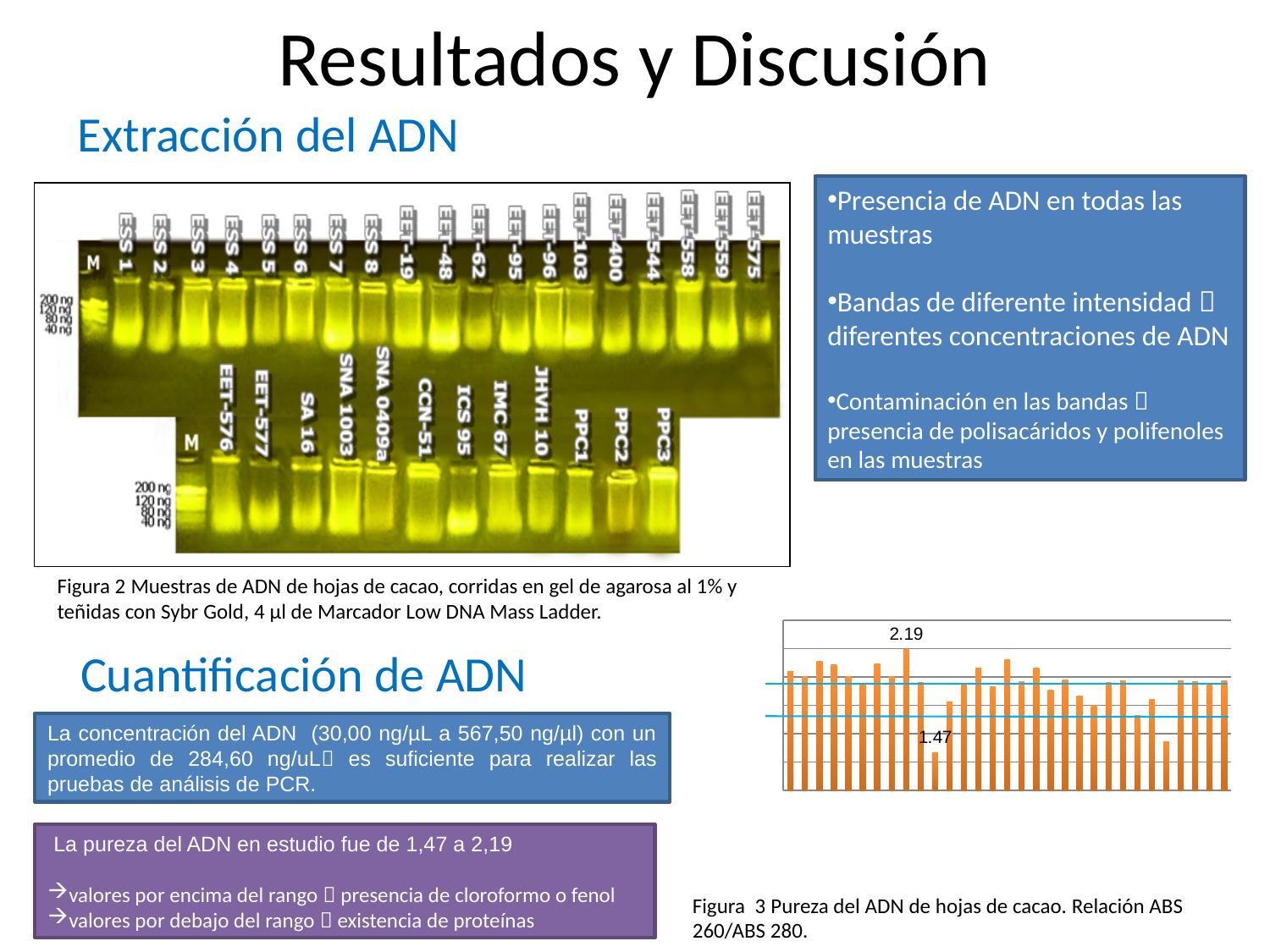
What colour are the bars in the Figura 3 bar chart? orange In the Figura 3 bar chart, what is the highest value labeled on the chart? 2.19 According to the caption, what does the bar chart in Figura 3 show? Pureza del ADN de hojas de cacao. Relación ABS 260/ABS 280. In the Figura 3 bar chart, what is the lowest value labeled on the chart? 1.47 In the Figura 3 bar chart, what is the difference between the highest labeled value (2.19) and the lowest labeled value (1.47)? 0.72 What kind of chart is shown at the bottom right of the slide (Figura 3)? bar chart